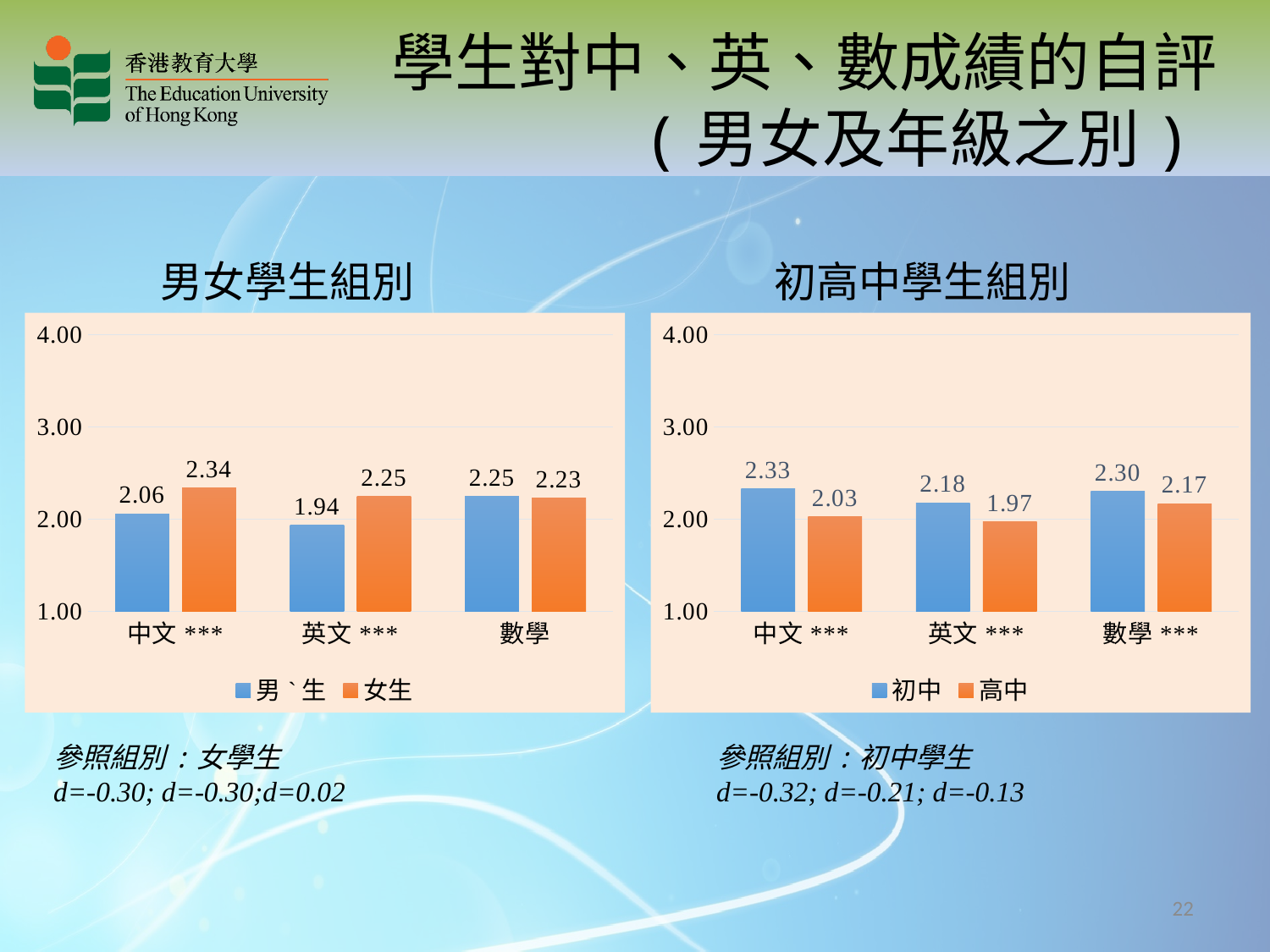
In the 男女學生組別 chart, is the value for 男生 in 英文 greater or less than 2.00? less In the 男女學生組別 chart, which subject has the lowest value for 男生? 英文 In the 男女學生組別 chart, what is the difference between the 女生 and 男生 values in 中文? 0.28 In the 男女學生組別 chart, what is the value for 女生 in 中文? 2.34 In the 初高中學生組別 chart, which is larger in 英文: 初中 or 高中? 初中 In the 初高中學生組別 chart, what is the value for 初中 in 數學? 2.30 In the 初高中學生組別 chart, what is the value for 高中 in 英文? 1.97 How many series does the legend of the 初高中學生組別 chart list? 2 In the 男女學生組別 chart, what is the value for 男生 in 英文? 1.94 What kind of chart is the 男女學生組別 chart? bar chart In the 初高中學生組別 chart, what is the difference between the 初中 and 高中 values in 中文? 0.30 In the 初高中學生組別 chart, which subject has the highest value for 初中? 中文